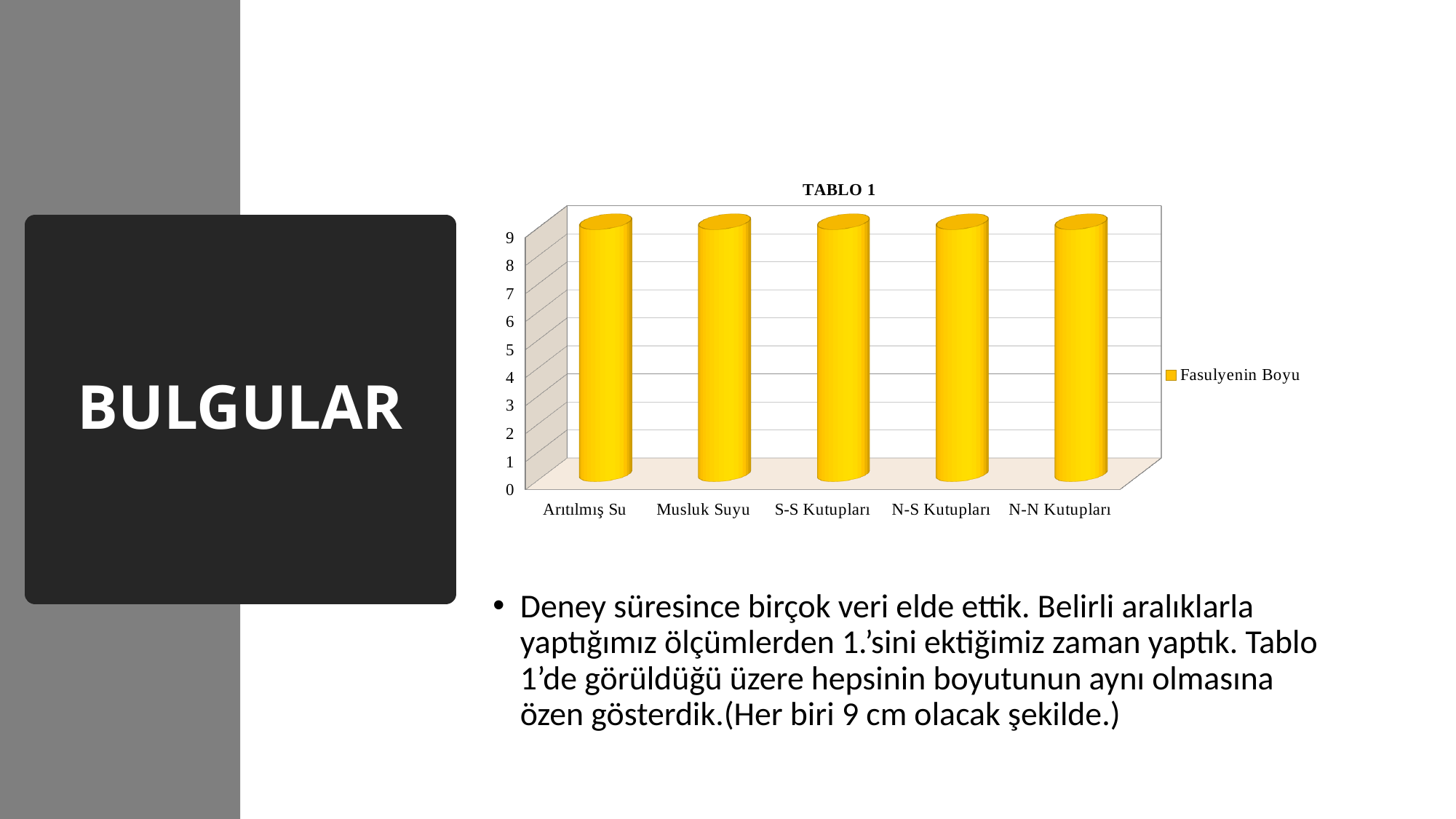
How many series does the legend of the TABLO 1 chart list? 1 What is the difference between the values for Arıtılmış Su and Musluk Suyu? 0 Is the value for S-S Kutupları greater or less than 5? greater What is the name of the series shown in the legend of the chart? Fasulyenin Boyu Do the values rise, fall, or stay the same across the categories from Arıtılmış Su to N-N Kutupları? stay the same What is the value for Musluk Suyu in the TABLO 1 chart? 9 What is the value for N-N Kutupları in the TABLO 1 chart? 9 How many categories are shown on the x axis of the TABLO 1 chart? 5 What kind of chart is shown under the title TABLO 1? bar chart What is the title of the chart on the slide? TABLO 1 What is the value for Arıtılmış Su in the TABLO 1 chart? 9 Is the value for N-S Kutupları greater or less than 4? greater